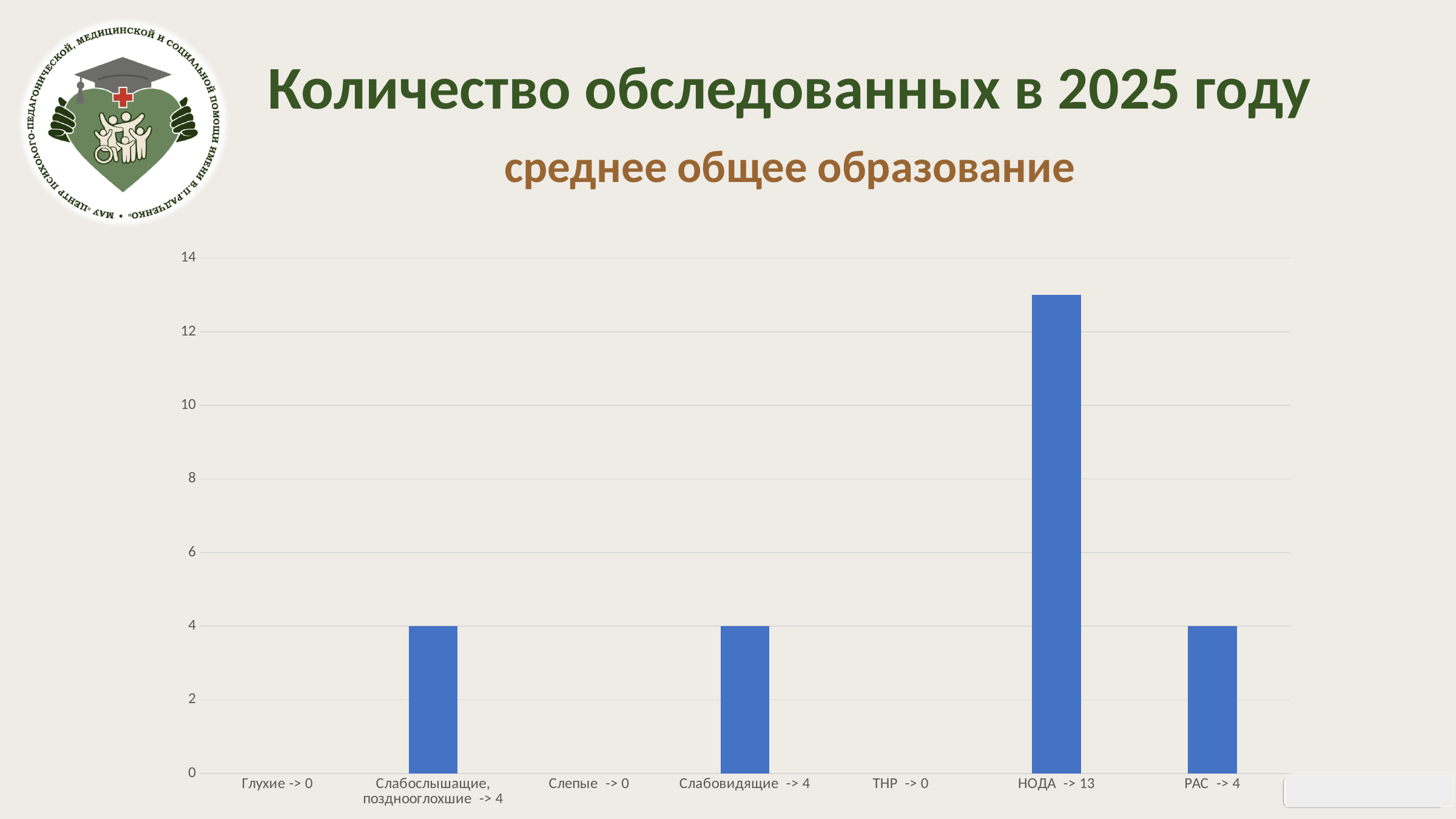
How many categories have a value of 0? 3 What is the difference between the values for НОДА and РАС? 9 Is the value for НОДА greater or less than 12? greater How many categories are shown on the x axis? 7 Which category has the highest value? НОДА Which is larger, the value for Слабослышащие, позднооглохшие or the value for ТНР? Слабослышащие, позднооглохшие What is the subtitle shown below the main title of the slide? среднее общее образование What is the value for РАС? 4 What is the value for Глухие? 0 What kind of chart is shown on the slide? bar chart What is the value for НОДА? 13 What is the value for Слабовидящие? 4